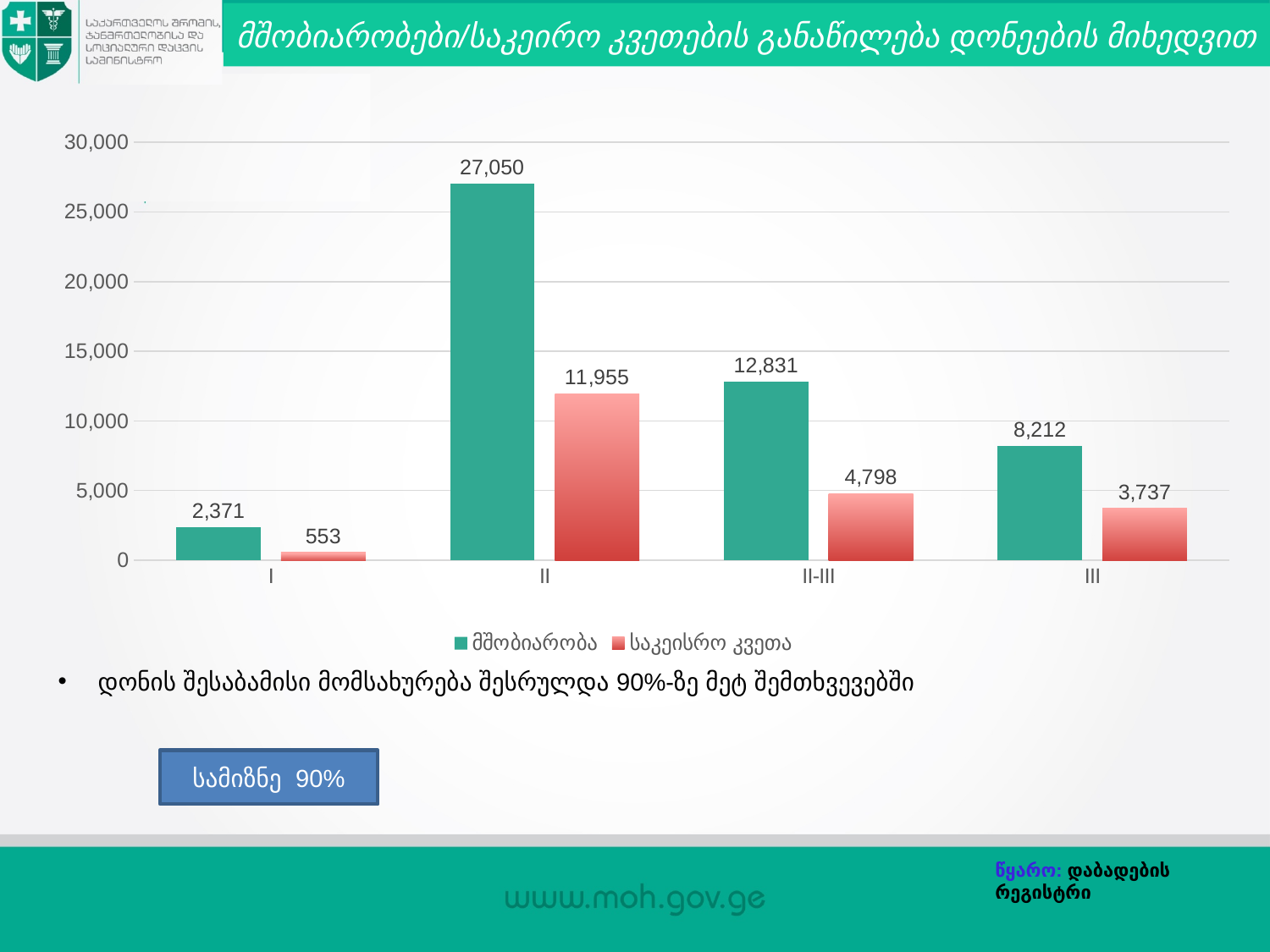
Which level has the lowest value for საკეისრო კვეთა? I How many series does the legend list? 2 What is the value of მშობიარობა for level II? 27,050 Which is larger: საკეისრო კვეთა for level II-III or საკეისრო კვეთა for level III? საკეისრო კვეთა for level II-III What is the value of საკეისრო კვეთა for level II-III? 4,798 How many levels (categories) are shown on the x axis? 4 What is the value of მშობიარობა for level III? 8,212 What is the value of საკეისრო კვეთა for level I? 553 What kind of chart is shown on the slide? Bar chart Is the value of მშობიარობა for level II-III greater or less than 10,000? greater Which level has the highest value for მშობიარობა? II What is the difference between მშობიარობა and საკეისრო კვეთა for level II? 15,095